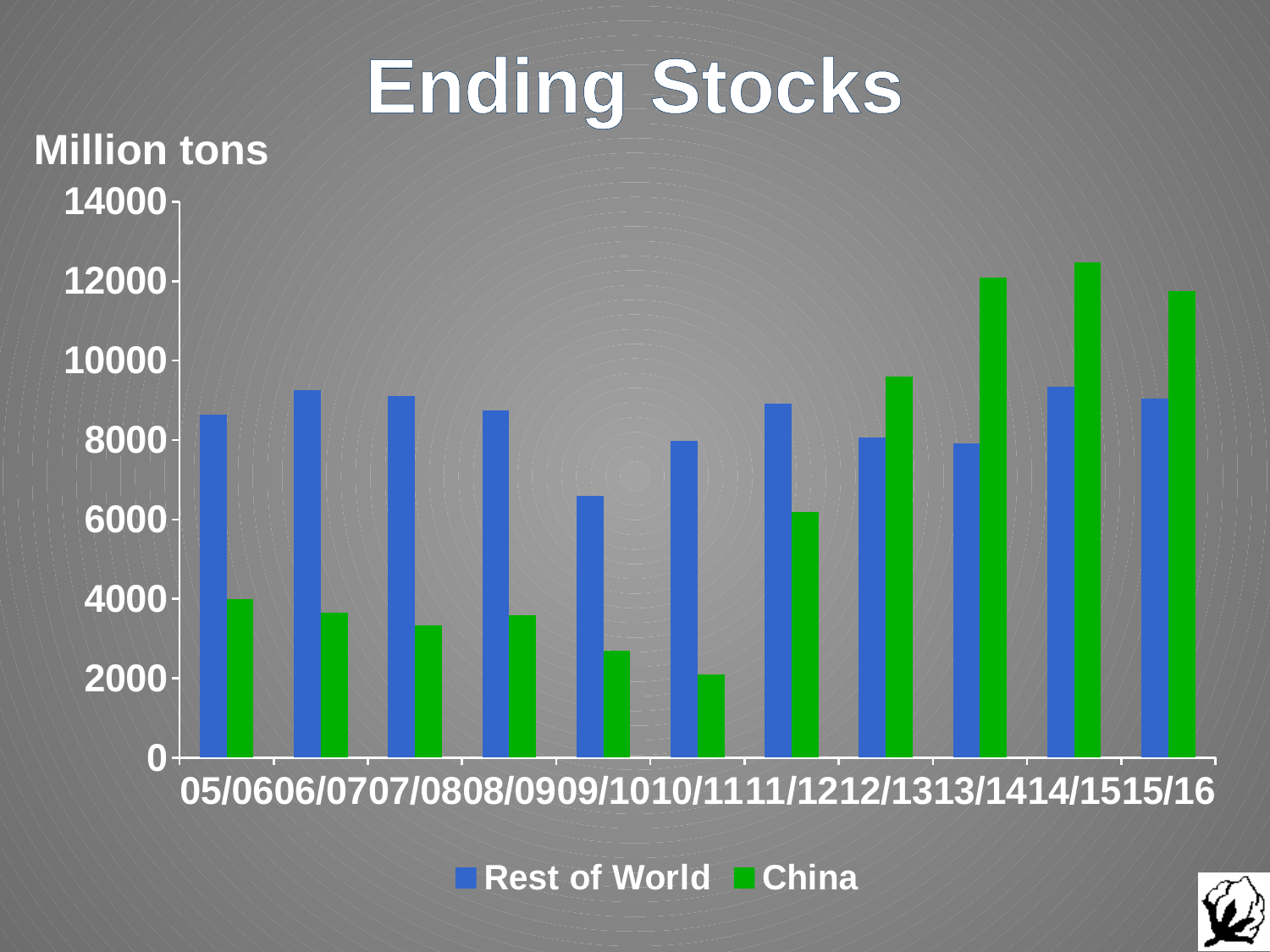
Is the value for China in 10/11 greater or less than 4000? less How many series does the legend list? 2 Is the value for China in 14/15 greater or less than 12000? greater In 15/16, which series has the larger ending stock, Rest of World or China? China How many seasons (categories) are shown on the x axis? 11 What kind of chart is shown on the slide? bar chart In which season is the China ending stock the highest? 14/15 In which season is the Rest of World ending stock the lowest? 09/10 Is the value for Rest of World in 09/10 greater or less than 8000? less In 05/06, which series has the larger ending stock, Rest of World or China? Rest of World What unit is given for the values on the chart? Million tons In which season is the China ending stock the lowest? 10/11